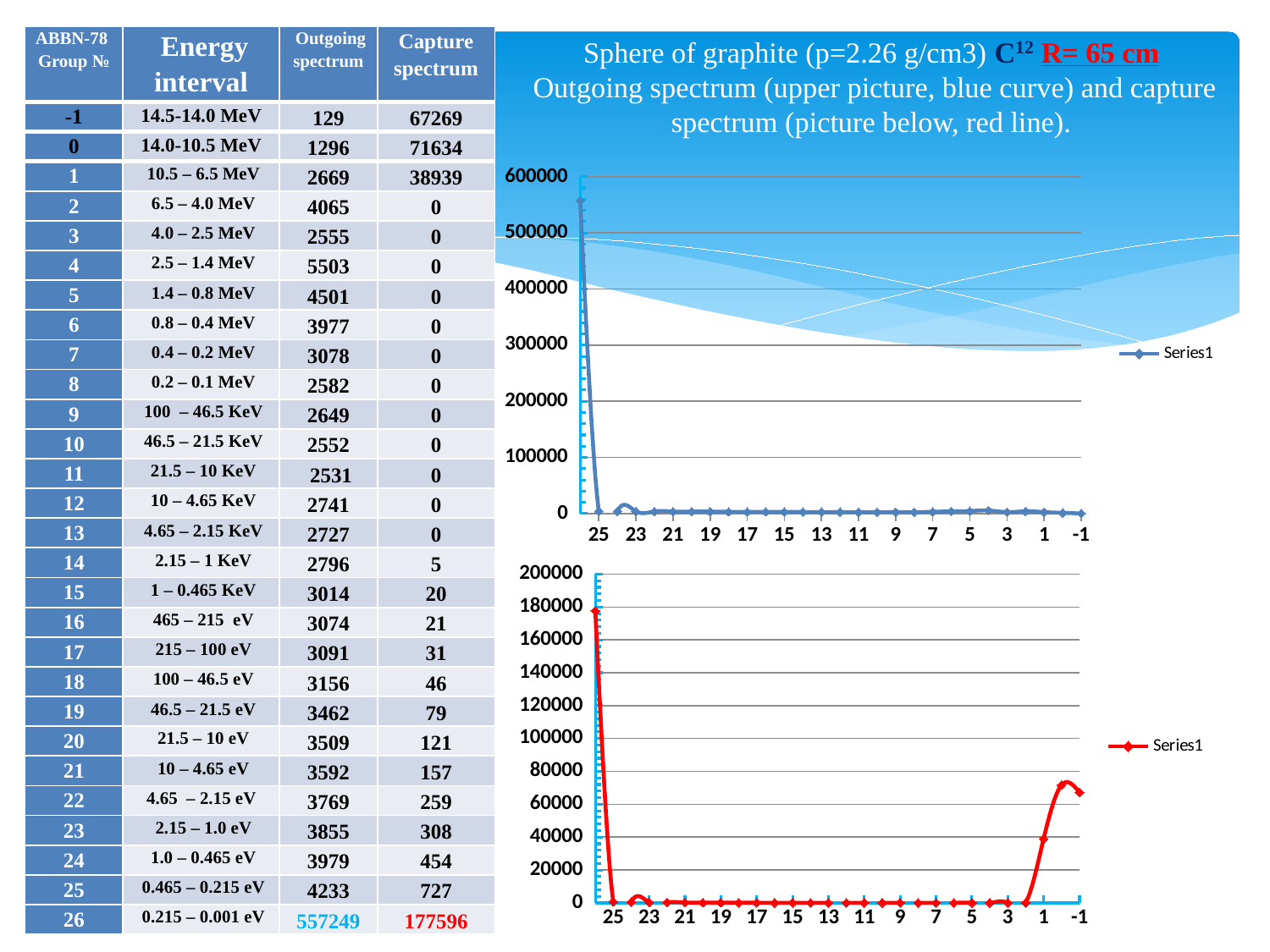
What kind of chart is the upper chart on the slide? line chart In the lower chart, do the values rise or fall along the x axis from x = 3 to x = -1? rise In the lower chart, is the value at x = 1 greater or less than 20000? greater In the lower chart, is the value at x = -1 greater or less than 80000? less How many tick labels are shown on the x axis of the lower chart? 14 In the lower chart, is the value of the leftmost point greater or less than 160000? greater What is the legend entry shown for the upper chart? Series1 In the upper chart, which is larger: the value at the leftmost point or the value at x = 25? the leftmost point What colour is the line in the lower chart? red In the lower chart, which is larger: the value at x = -1 or the value at x = 1? x = -1 How many series does the legend of the lower chart list? 1